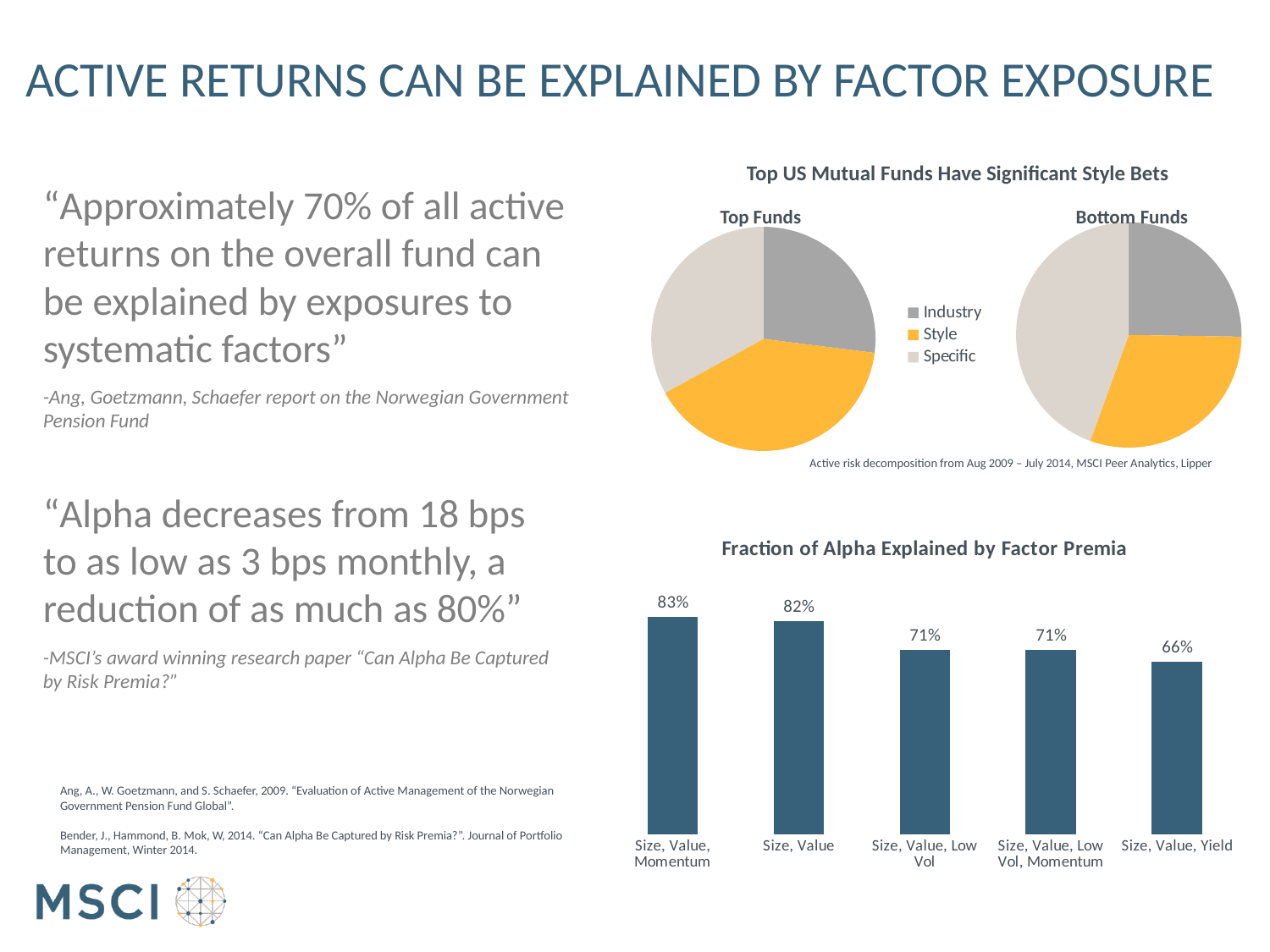
What kind of chart is 'Fraction of Alpha Explained by Factor Premia'? Bar chart In the 'Fraction of Alpha Explained by Factor Premia' chart, which is larger: the value for Size, Value or the value for Size, Value, Low Vol, Momentum? Size, Value In the 'Bottom Funds' pie chart, which slice is the largest? Specific How many entries does the legend list for the 'Top US Mutual Funds Have Significant Style Bets' pie charts? 3 In the 'Fraction of Alpha Explained by Factor Premia' chart, what is the value for Size, Value, Yield? 66% In the 'Fraction of Alpha Explained by Factor Premia' chart, which category has the lowest value? Size, Value, Yield In the 'Fraction of Alpha Explained by Factor Premia' chart, do the values rise or fall from left to right? Fall In the 'Fraction of Alpha Explained by Factor Premia' chart, what is the value for Size, Value, Low Vol? 71% In the 'Fraction of Alpha Explained by Factor Premia' chart, which category has the highest value? Size, Value, Momentum How many categories are shown in the 'Fraction of Alpha Explained by Factor Premia' chart? 5 In the 'Fraction of Alpha Explained by Factor Premia' chart, what is the difference between the values for Size, Value, Momentum and Size, Value, Yield? 17 percentage points In the 'Fraction of Alpha Explained by Factor Premia' chart, what is the value for Size, Value, Momentum? 83%